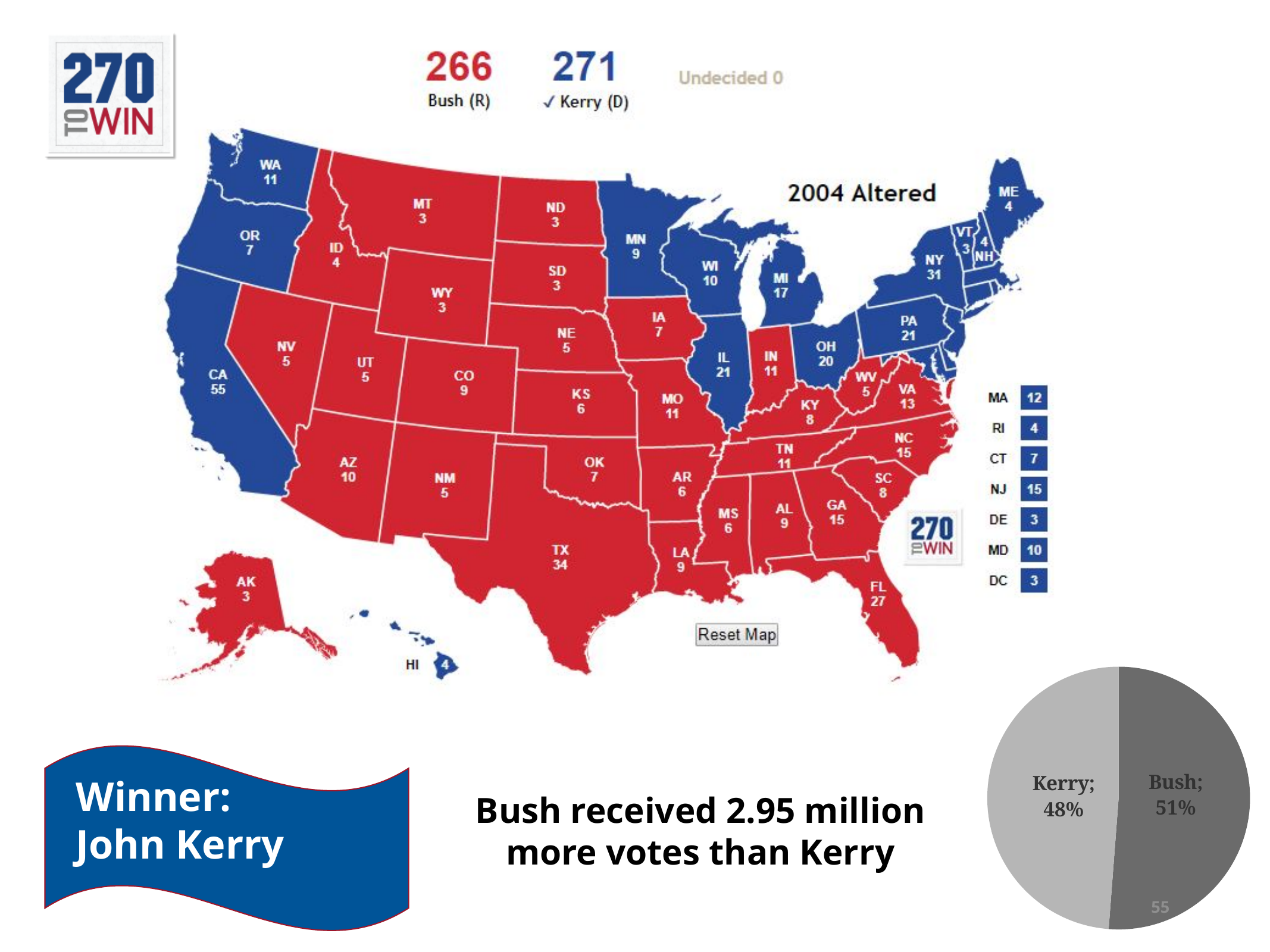
What kind of chart is shown at the bottom right of the slide? pie chart On the electoral map, how many electoral votes are shown for Kerry (D)? 271 In the pie chart at the bottom right, by how many percentage points does Bush's share exceed Kerry's? 3 percentage points On the electoral map, how many electoral votes are shown for Bush (R)? 266 In the pie chart at the bottom right, what share does Bush have? 51% In the pie chart at the bottom right, what share does Kerry have? 48% In the pie chart at the bottom right, which candidate has the larger slice? Bush In the pie chart at the bottom right, is Kerry's share greater or less than 50%? less How many slices does the pie chart at the bottom right have? 2 On the electoral map, how many electoral votes does CA have? 55 In the pie chart at the bottom right, which candidate has the smaller slice? Kerry In the pie chart at the bottom right, is Kerry's share larger or smaller than Bush's? smaller